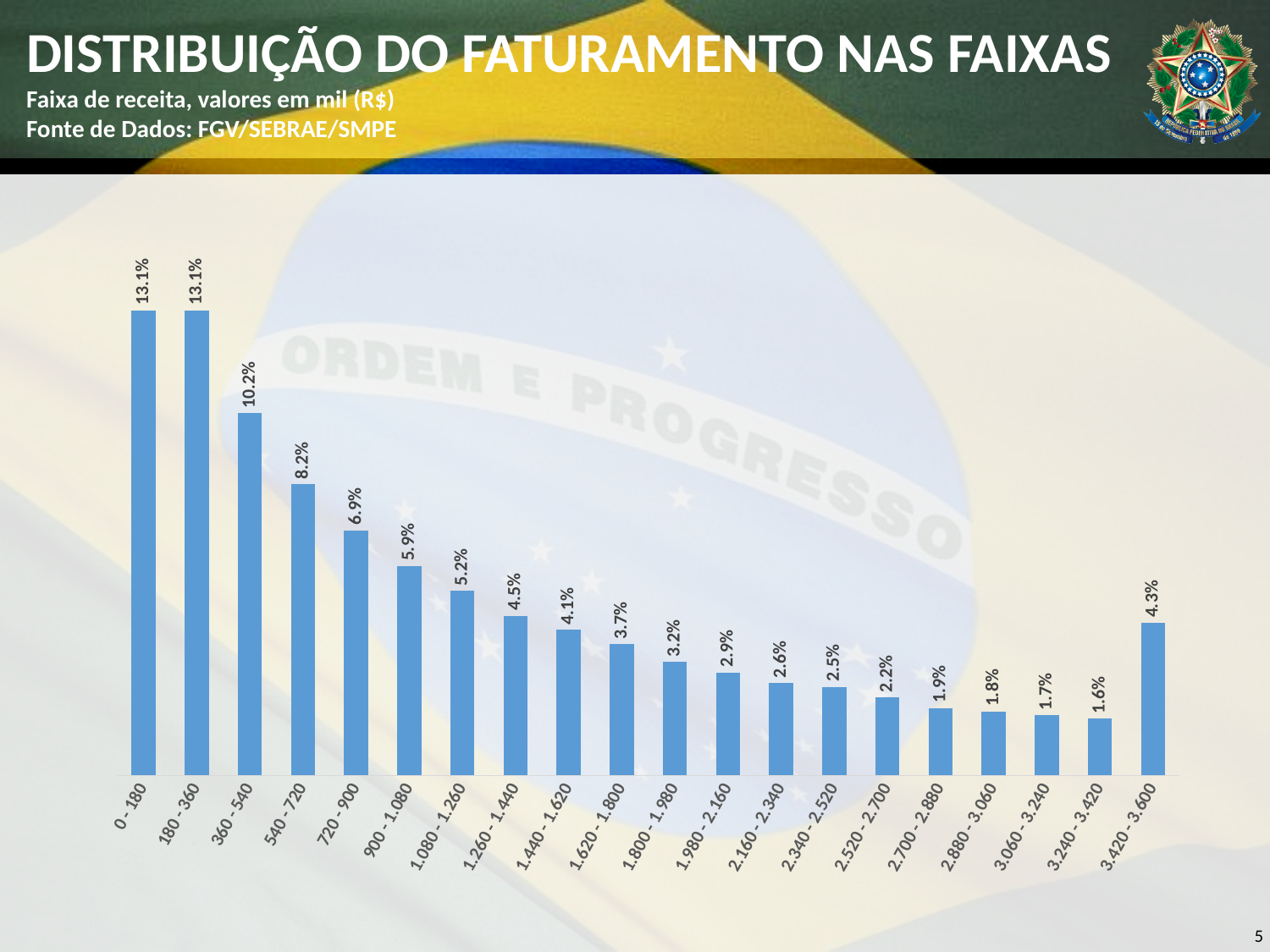
Which is larger, the value for 900 - 1.080 or the value for 1.260 - 1.440? 900 - 1.080 How many revenue ranges are shown on the chart? 20 What is the value for the 2.340 - 2.520 range? 2.5% What is the value for the 3.420 - 3.600 range? 4.3% What is the difference between the values for 0 - 180 and 360 - 540? 2.9% Which is larger, the value for 3.420 - 3.600 or the value for 1.620 - 1.800? 3.420 - 3.600 What is the value for the 1.080 - 1.260 range? 5.2% What is the difference between the values for 540 - 720 and 720 - 900? 1.3% Which range has the lowest value? 3.240 - 3.420 Do the values generally rise or fall from the 0 - 180 range to the 3.240 - 3.420 range? Fall What is the value for the 360 - 540 range? 10.2% What kind of chart is shown on the slide? Bar chart